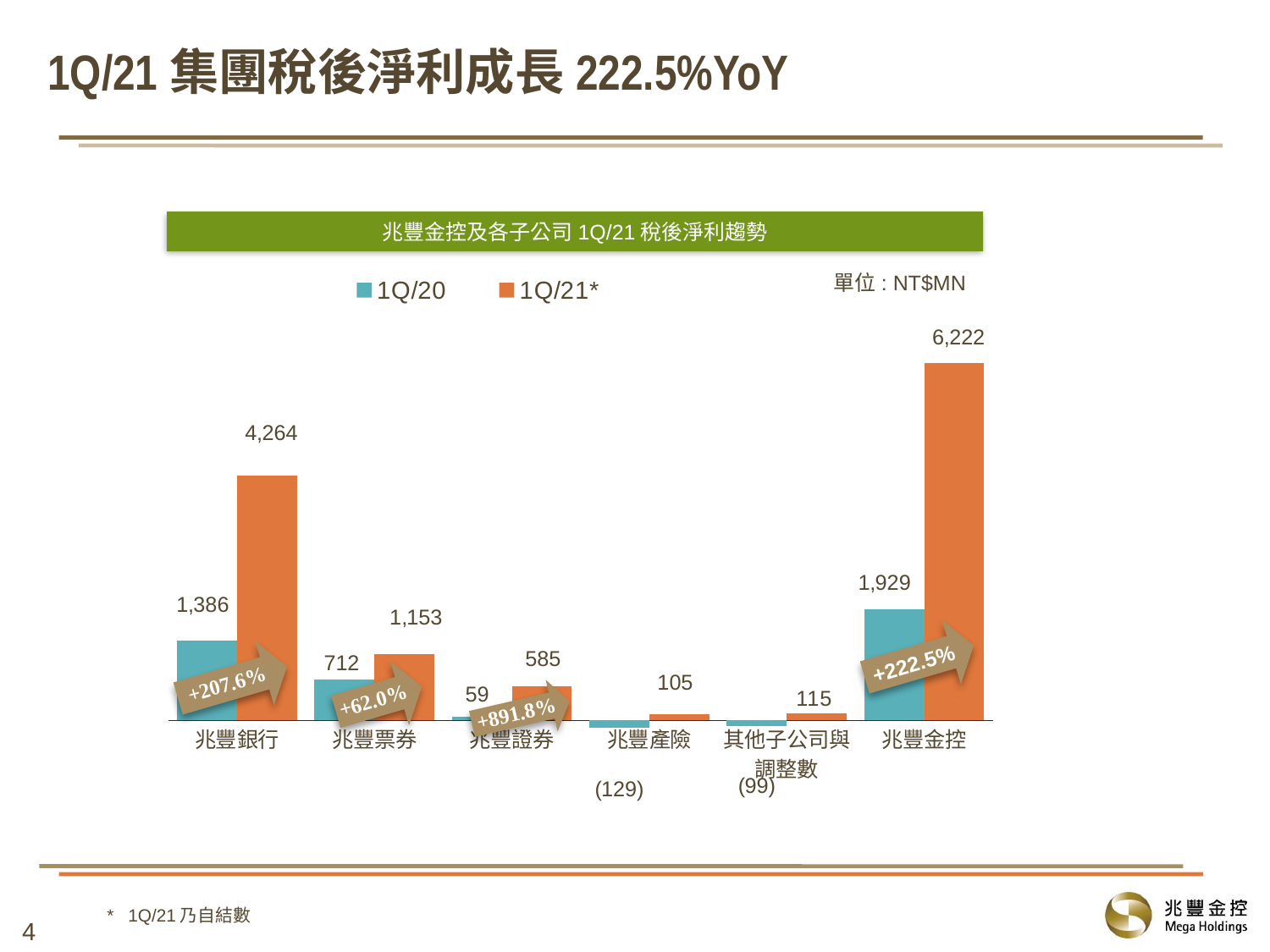
How many categories are shown on the x axis? 6 What is the difference between the 1Q/21* and 1Q/20 values for 兆豐票券? 441 What is the 1Q/20 value for 兆豐產險? (129) What is the 1Q/21* value for 兆豐證券? 585 Which category has the lowest 1Q/20 value? 兆豐產險 Which is larger for 兆豐證券: the 1Q/20 value or the 1Q/21* value? 1Q/21* What kind of chart is shown on the slide? Bar chart What is the 1Q/20 value for 兆豐金控? 1,929 How many series does the legend list? 2 What is the 1Q/21* value for 兆豐銀行? 4,264 Which category has the highest 1Q/21* value? 兆豐金控 What growth percentage is shown on the arrow for 兆豐金控? +222.5%